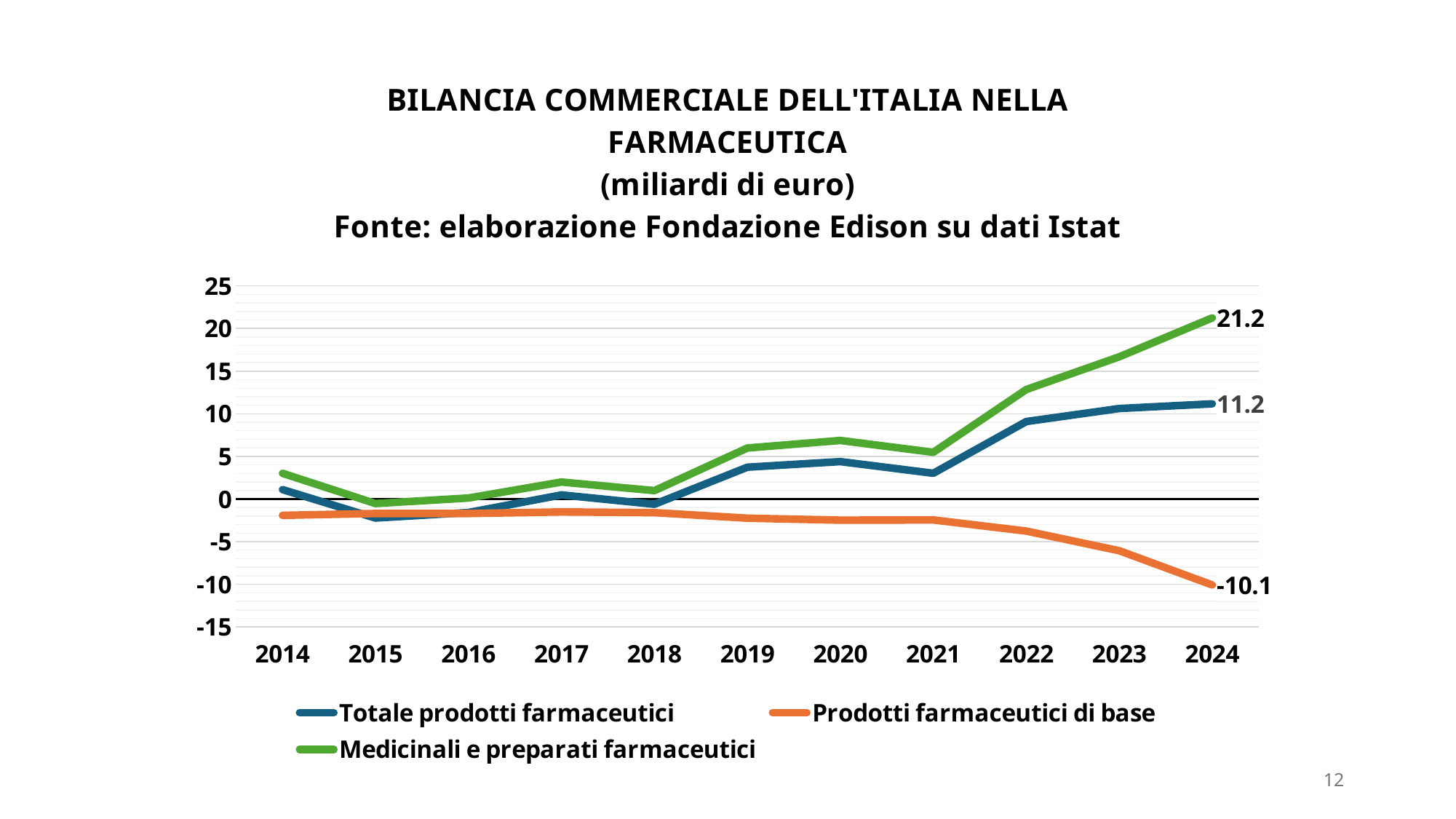
Is the value for Prodotti farmaceutici di base in 2023 greater or less than -5? less How many years are shown on the x axis? 11 Is the value for Medicinali e preparati farmaceutici in 2022 greater or less than 10? greater What is the value for Totale prodotti farmaceutici in 2024? 11.2 What is the value for Medicinali e preparati farmaceutici in 2024? 21.2 Which series has the highest value in 2024? Medicinali e preparati farmaceutici In 2024, which is larger: Totale prodotti farmaceutici or Prodotti farmaceutici di base? Totale prodotti farmaceutici What is the difference between the 2024 values of Medicinali e preparati farmaceutici and Totale prodotti farmaceutici? 10.0 Which series has the lowest value in 2024? Prodotti farmaceutici di base How many series does the legend list? 3 What kind of chart is shown on the slide? Line chart What is the value for Prodotti farmaceutici di base in 2024? -10.1